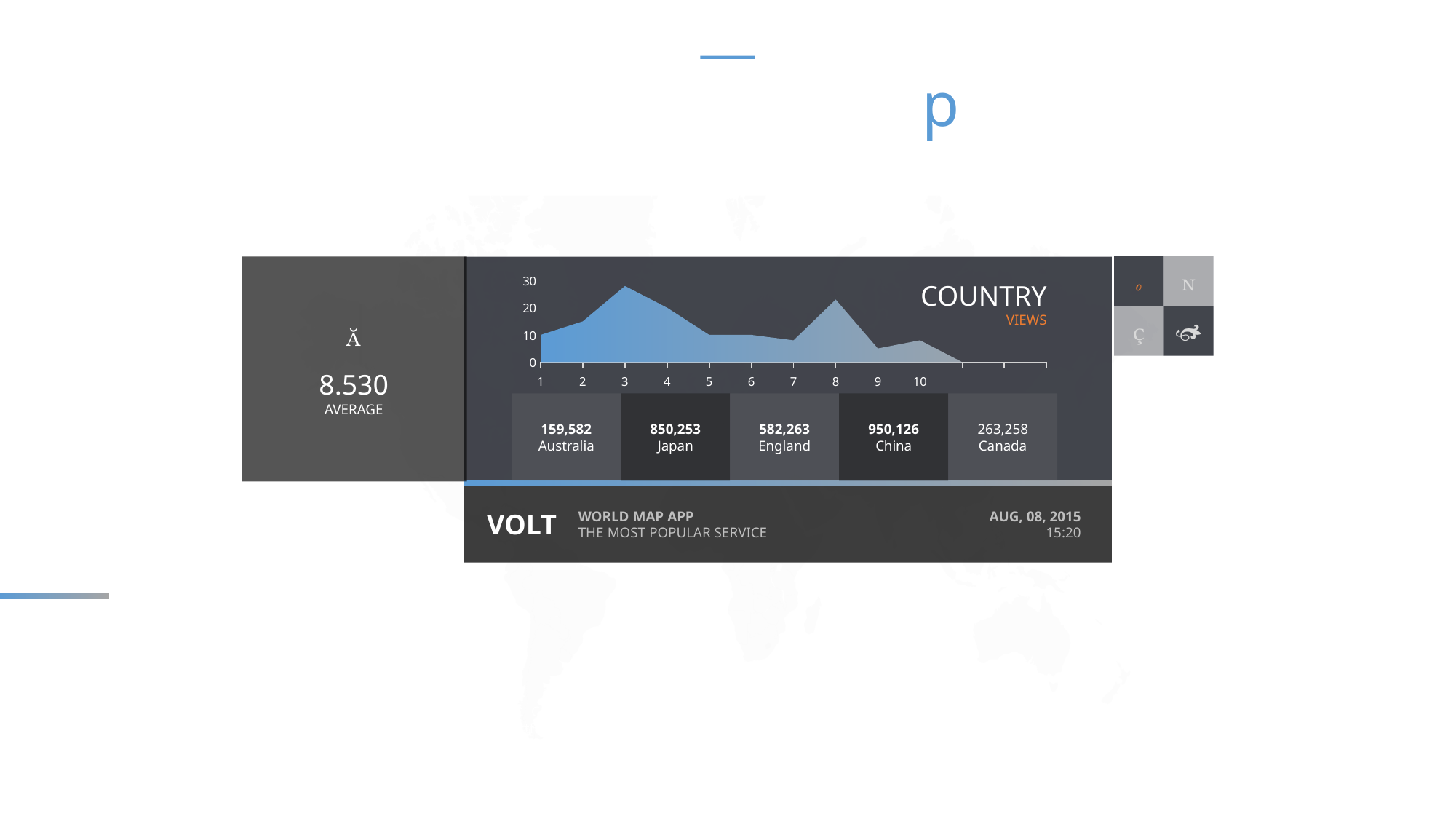
What kind of chart is shown on the slide? area chart What is the title of the chart? COUNTRY VIEWS What is the difference between the views figures for China and Japan? 99,873 At which x-axis point does the chart reach its highest value? 3 Which country listed below the chart has the highest views figure? China Is the value at point 3 greater or less than 20? greater Do the values rise or fall from point 3 to point 5? fall Is the value at point 6 greater or less than 20? less Do the values rise or fall from point 1 to point 3? rise What is the views figure shown for Japan? 850,253 How many numbered points are labelled along the x axis of the chart? 10 Is the value at point 9 greater or less than 10? less